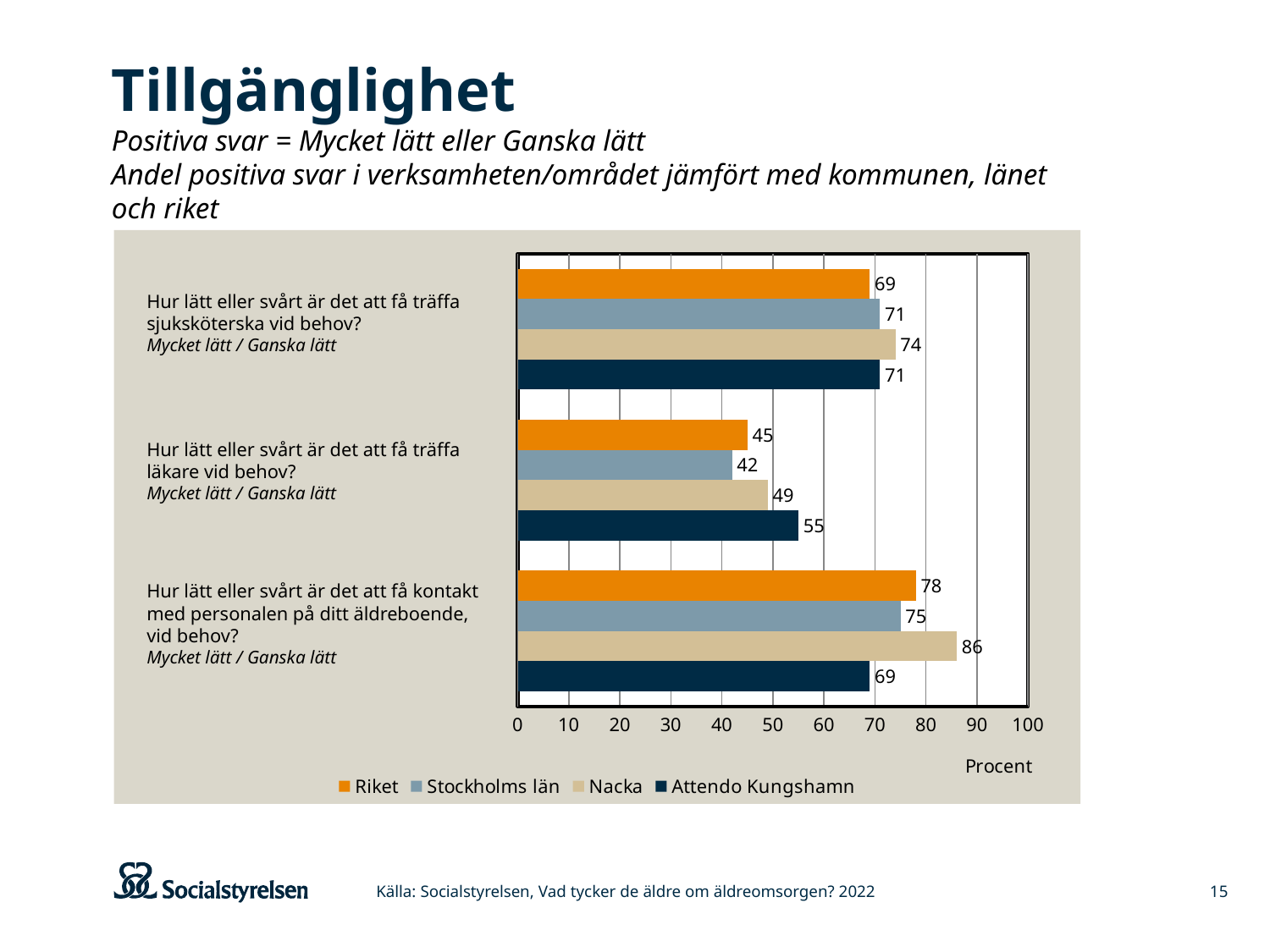
What is the difference between Nacka and Attendo Kungshamn on the question about getting in contact with staff at the care home? 17 What kind of chart is shown on the slide? Bar chart What is the value for Nacka on the question about getting in contact with staff at the care home (kontakt med personalen)? 86 How many series does the legend list? 4 What is the value for Attendo Kungshamn on the question about meeting a doctor (läkare) when needed? 55 How many questions (categories) are shown in the chart? 3 What is the value for Riket on the question about meeting a nurse (sjuksköterska) when needed? 69 Which is larger on the question about meeting a doctor when needed: Riket or Nacka? Nacka What unit label is shown under the x axis of the chart? Procent Which series has the highest value on the question about getting in contact with staff at the care home? Nacka Is the value for Stockholms län on the question about meeting a doctor when needed greater or less than 50? less Which series has the lowest value on the question about meeting a doctor when needed? Stockholms län